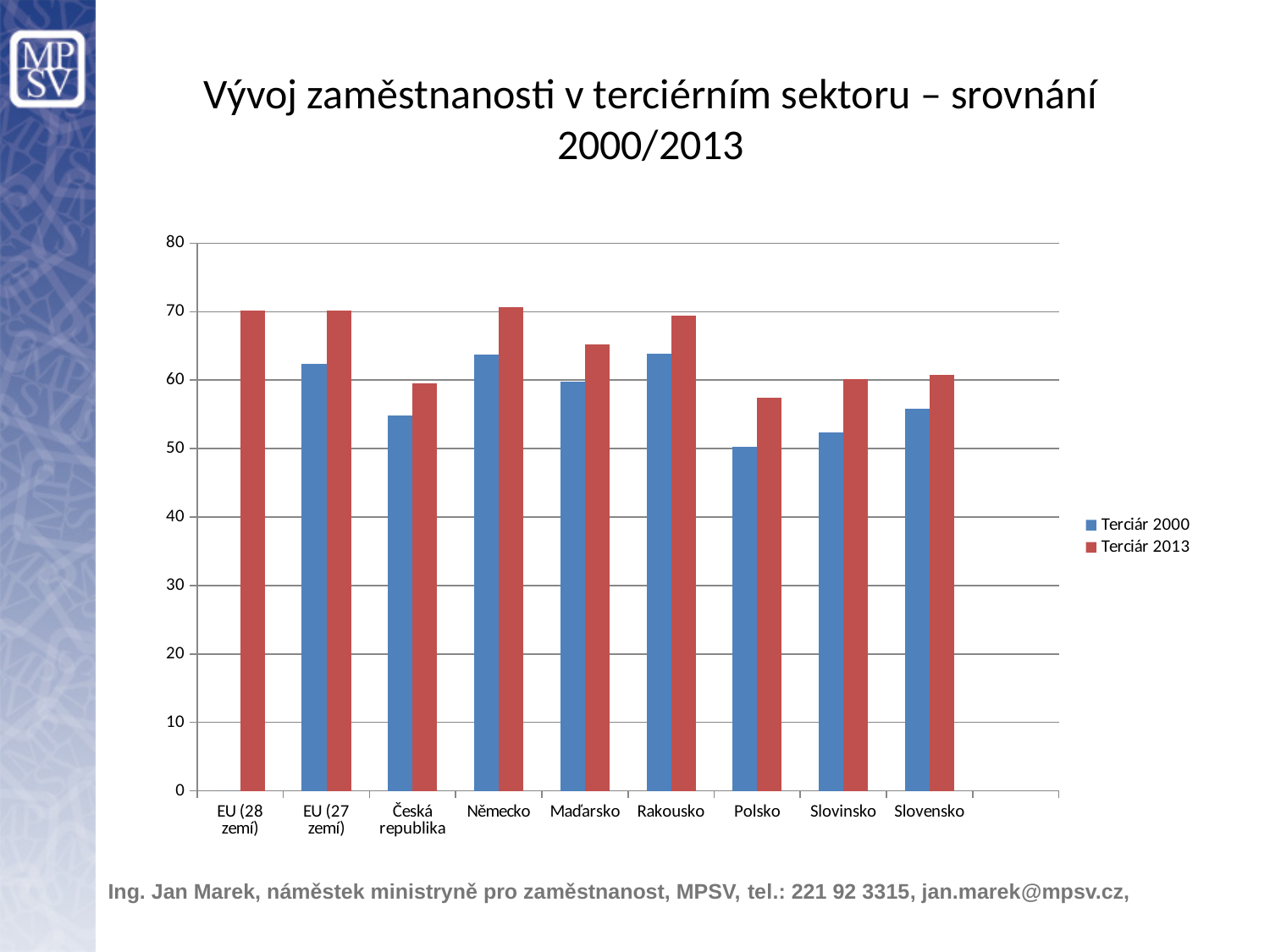
Is the value for Terciár 2013 for Maďarsko greater or less than 60? greater For Slovensko, is the Terciár 2013 value higher or lower than the Terciár 2000 value? higher Is the value for Terciár 2000 for EU (27 zemí) greater or less than 60? greater Which category has the lowest value for Terciár 2013? Polsko How many series does the legend list? 2 Is the value for Terciár 2000 for Česká republika greater or less than 60? less What kind of chart is shown on the slide? bar chart How many categories are shown on the x axis? 9 Which is larger for Terciár 2013: Polsko or Slovinsko? Slovinsko Which colour represents the Terciár 2013 series? red